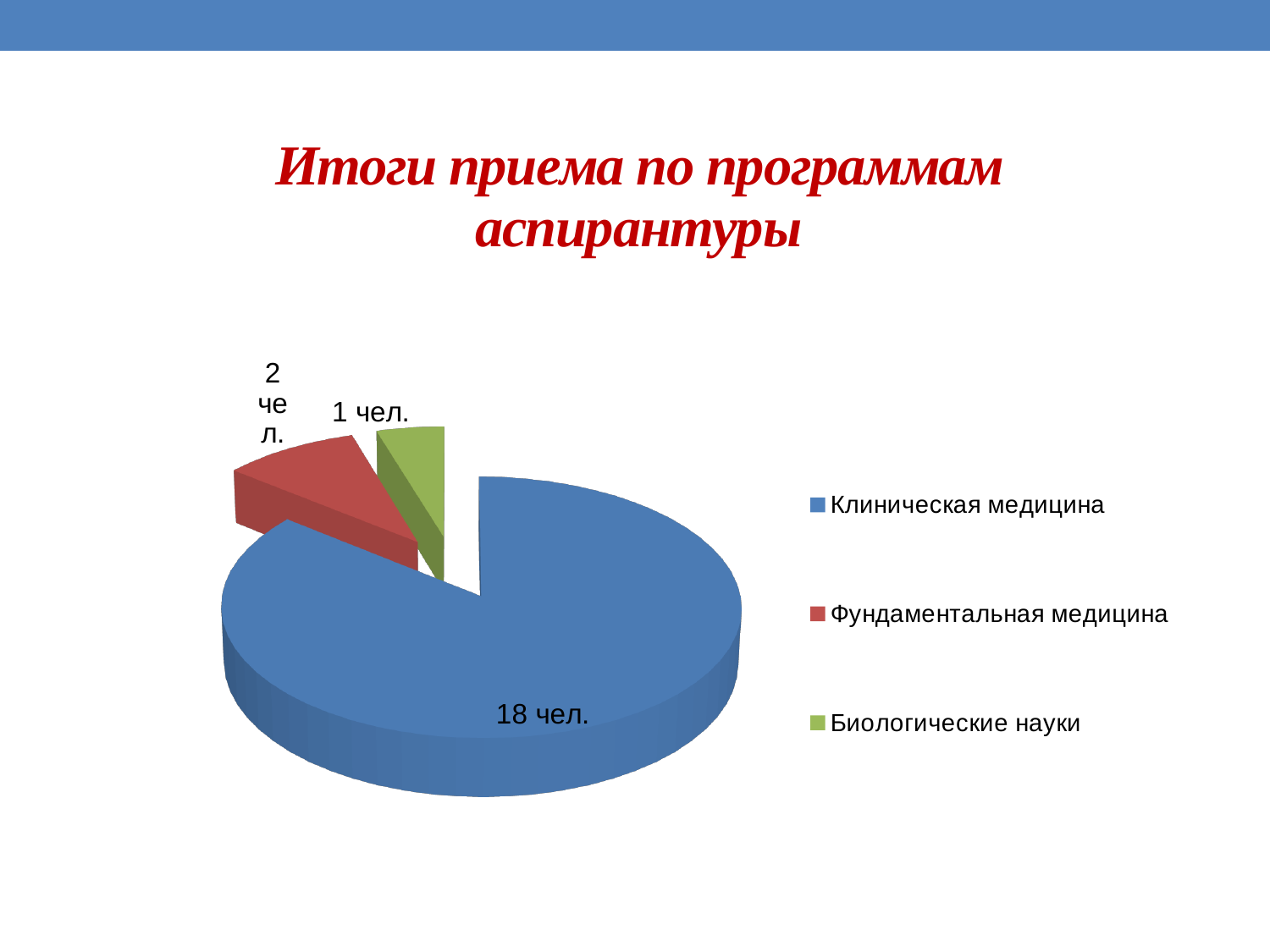
How many people were admitted to Фундаментальная медицина? 2 чел. What is the total number of people across all slices of the pie? 21 How many categories does the pie chart show? 3 What is the difference between the number admitted to Клиническая медицина and Фундаментальная медицина? 16 Which is larger: the value for Фундаментальная медицина or Биологические науки? Фундаментальная медицина What kind of chart is shown on the slide? pie chart Which category has the largest slice of the pie? Клиническая медицина Which category has the smallest slice of the pie? Биологические науки What colour is the slice for Биологические науки? green How many people were admitted to Клиническая медицина? 18 чел. How many people were admitted to Биологические науки? 1 чел. What is the title of the slide? Итоги приема по программам аспирантуры